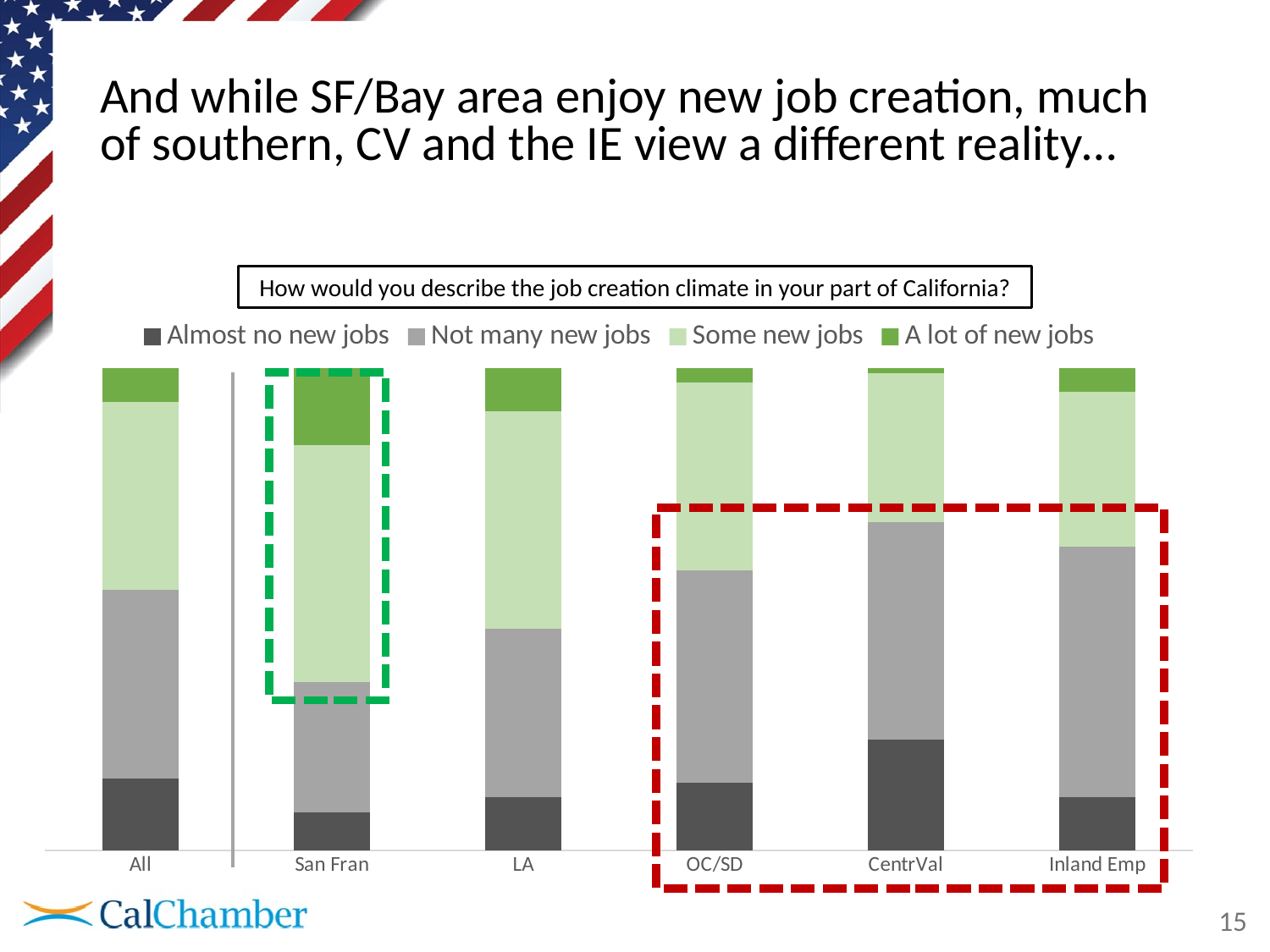
Which region has the smallest 'A lot of new jobs' segment? CentrVal Which region has the smallest 'Almost no new jobs' segment? San Fran Which series is listed first in the chart legend? Almost no new jobs What kind of chart is shown on the slide? Stacked bar chart Which region has the largest 'Almost no new jobs' segment? CentrVal Which region has the largest 'A lot of new jobs' segment? San Fran What question is shown as the title of the chart? How would you describe the job creation climate in your part of California? Is the 'A lot of new jobs' segment larger for San Fran or for LA? San Fran Which region has the smallest 'Not many new jobs' segment? San Fran How many series does the chart legend list? 4 Is the 'Almost no new jobs' segment larger for CentrVal or for OC/SD? CentrVal How many categories (regions) are shown along the x axis of the chart? 6